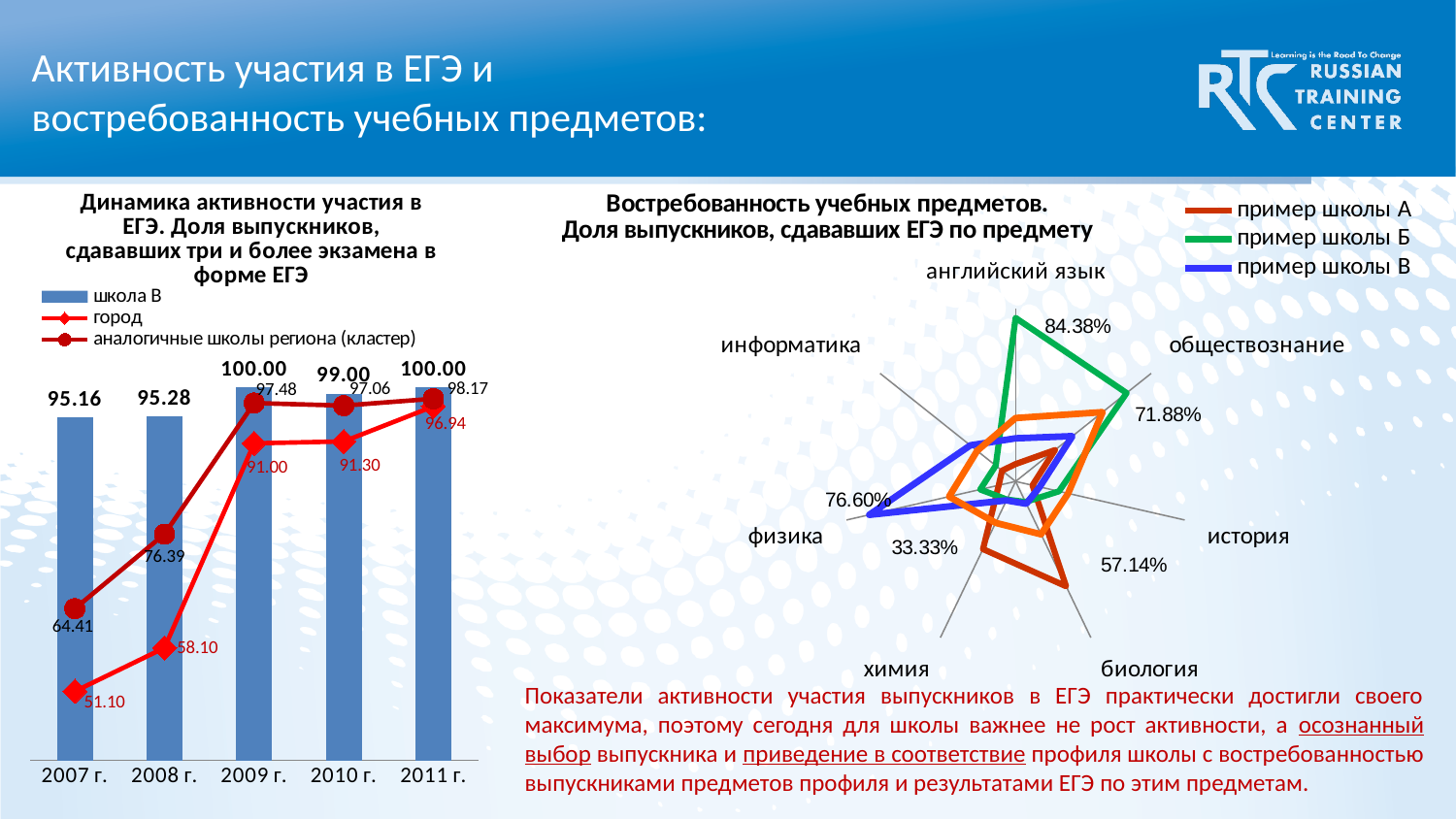
What kind of chart is the left chart titled 'Динамика активности участия в ЕГЭ'? bar chart with line series In the left chart 'Динамика активности участия в ЕГЭ', does the value for город rise or fall from 2007 г. to 2011 г.? rise In the right radar chart 'Востребованность учебных предметов', what value is labelled on the английский язык axis? 84.38% How many series does the legend of the right radar chart 'Востребованность учебных предметов' list? 3 In the left chart 'Динамика активности участия в ЕГЭ', in which year is the value for город lowest? 2007 г. In the left chart 'Динамика активности участия в ЕГЭ', what is the value for город in 2007 г.? 51.10 In the left chart 'Динамика активности участия в ЕГЭ', what is the value for школа В in 2007 г.? 95.16 In the left chart 'Динамика активности участия в ЕГЭ', what is the difference between школа В and город in 2007 г.? 44.06 In the left chart 'Динамика активности участия в ЕГЭ', what is the value for аналогичные школы региона (кластер) in 2008 г.? 76.39 In the left chart 'Динамика активности участия в ЕГЭ', which is larger in 2010 г.: школа В or аналогичные школы региона (кластер)? школа В How many years are shown on the x axis of the left chart 'Динамика активности участия в ЕГЭ'? 5 How many series does the legend of the left chart 'Динамика активности участия в ЕГЭ' list? 3